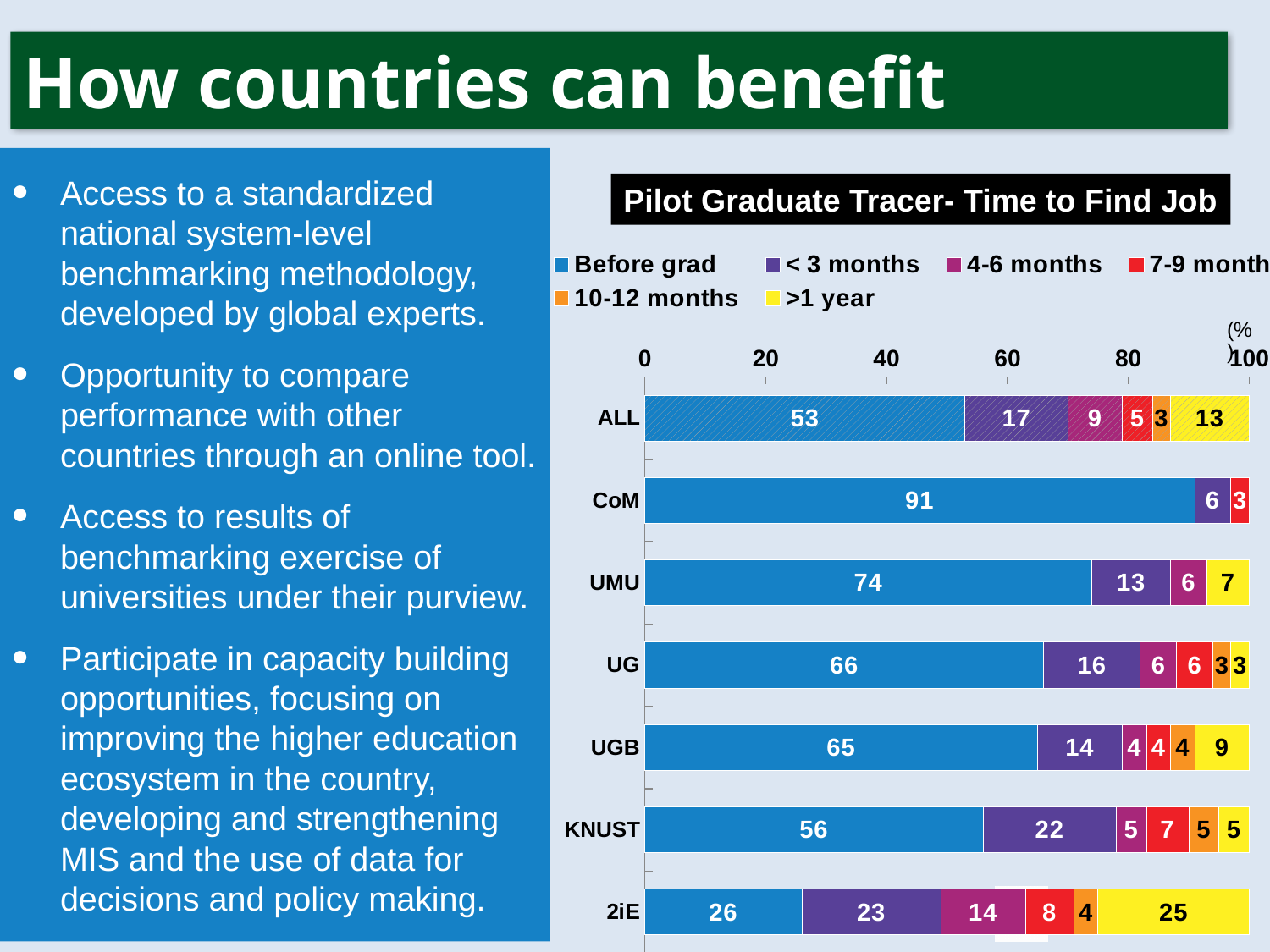
Which category has the lowest 'Before grad' value? 2iE What is the title of the chart? Pilot Graduate Tracer- Time to Find Job How many categories (institutions, including ALL) are shown on the chart? 7 What is the '>1 year' value for 2iE? 25 What is the difference between the 'Before grad' values for UMU and UG? 8 Which has the larger '< 3 months' value, KNUST or UG? KNUST What is the 'Before grad' value for CoM? 91 What kind of chart is shown on the slide? Stacked bar chart How many series does the legend list? 6 Which category has the highest 'Before grad' value? CoM What is the '< 3 months' value for ALL? 17 What is the '>1 year' value for UGB? 9